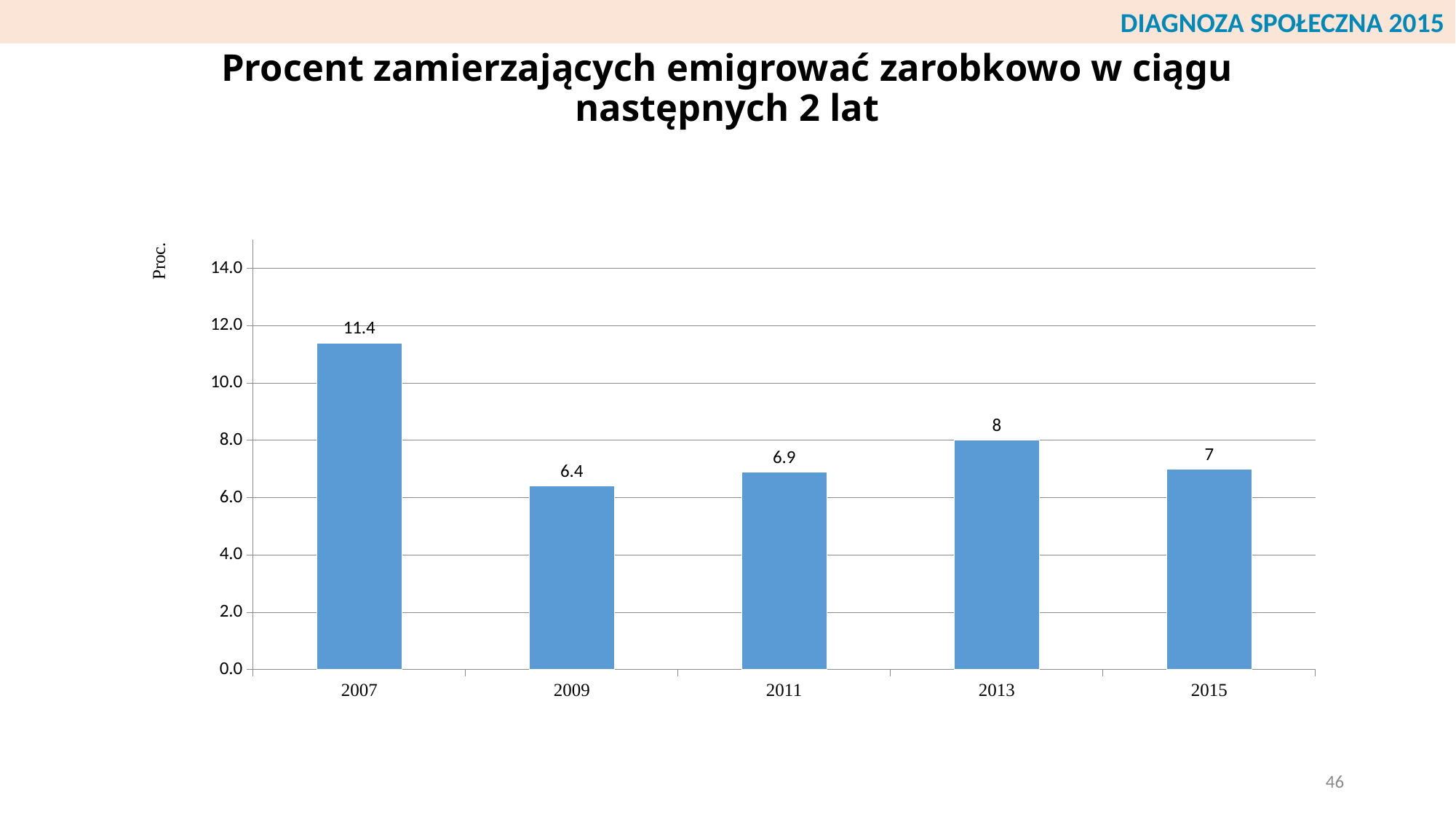
What is the value for 2009? 6.4 Is the value for 2011 greater or less than 8.0? less Which year has the highest value? 2007 How many years are shown on the x axis? 5 What is the difference between the values for 2007 and 2009? 5 Which is larger, the value for 2011 or the value for 2013? 2013 What is the difference between the values for 2013 and 2015? 1 What is the value for 2015? 7 What kind of chart is shown on the slide? bar chart What is the value for 2013? 8 Which year has the lowest value? 2009 What is the value for 2007? 11.4